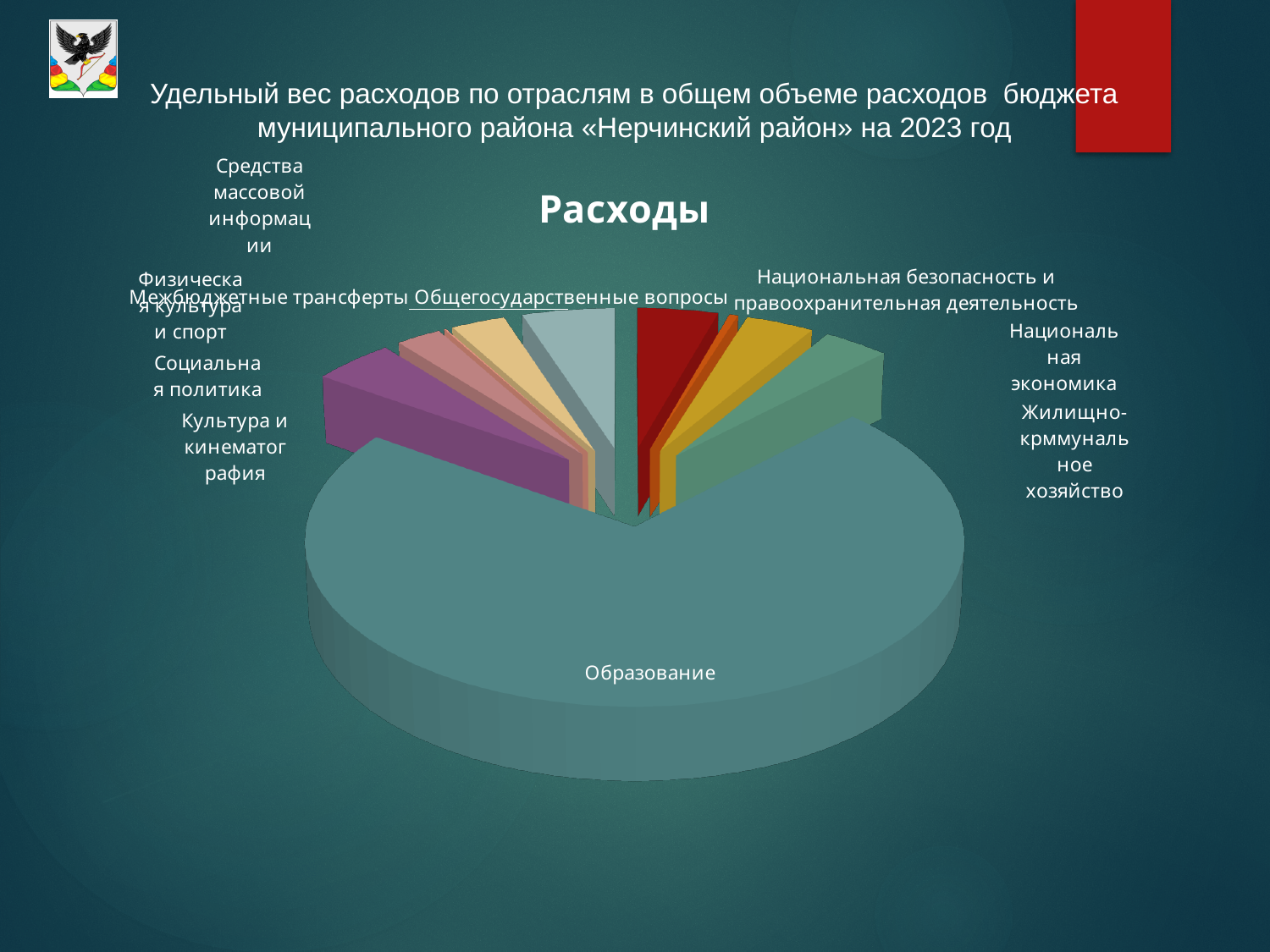
Which slice is larger: Образование or Национальная экономика? Образование Which category has the largest slice in the pie chart? Образование Which slice is larger: Образование or Культура и кинематография? Образование For which year does the slide show the share of expenditures by sector? 2023 What is the title of the pie chart? Расходы What kind of chart is shown on the slide? Pie chart Which slice is larger: Образование or Общегосударственные вопросы? Образование